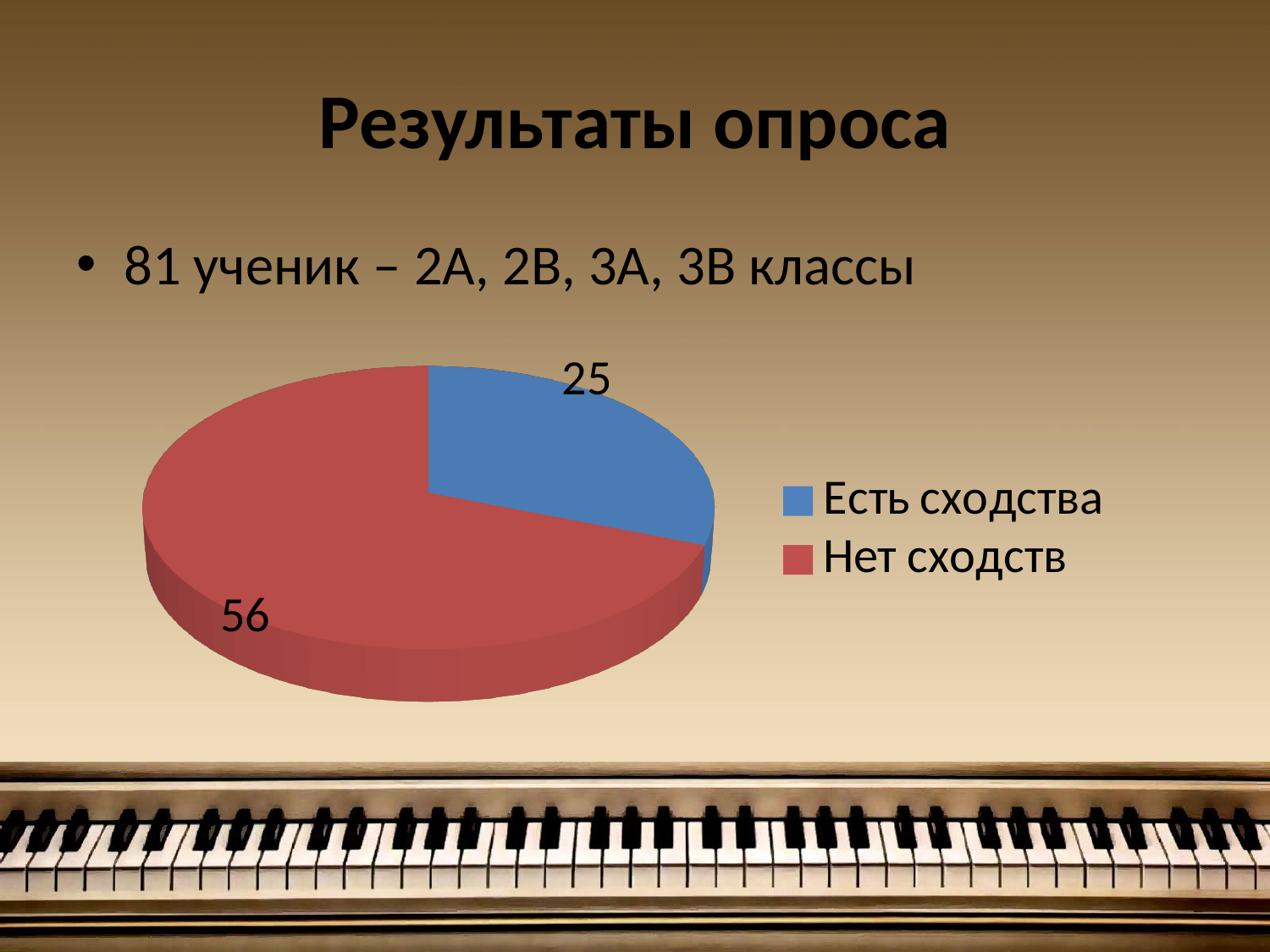
Which category has the largest slice? Нет сходств Which category has the smallest slice? Есть сходства Which is larger, the value for "Есть сходства" or the value for "Нет сходств"? Нет сходств What is the title of the slide containing the chart? Результаты опроса What is the value for "Нет сходств"? 56 What is the value for "Есть сходства"? 25 How many entries does the legend list? 2 What is the total of the two slices in the pie chart? 81 What is the difference between the values for "Нет сходств" and "Есть сходства"? 31 What colour is the slice for "Нет сходств"? red What type of chart is shown on the slide? pie chart How many slices does the pie chart have? 2